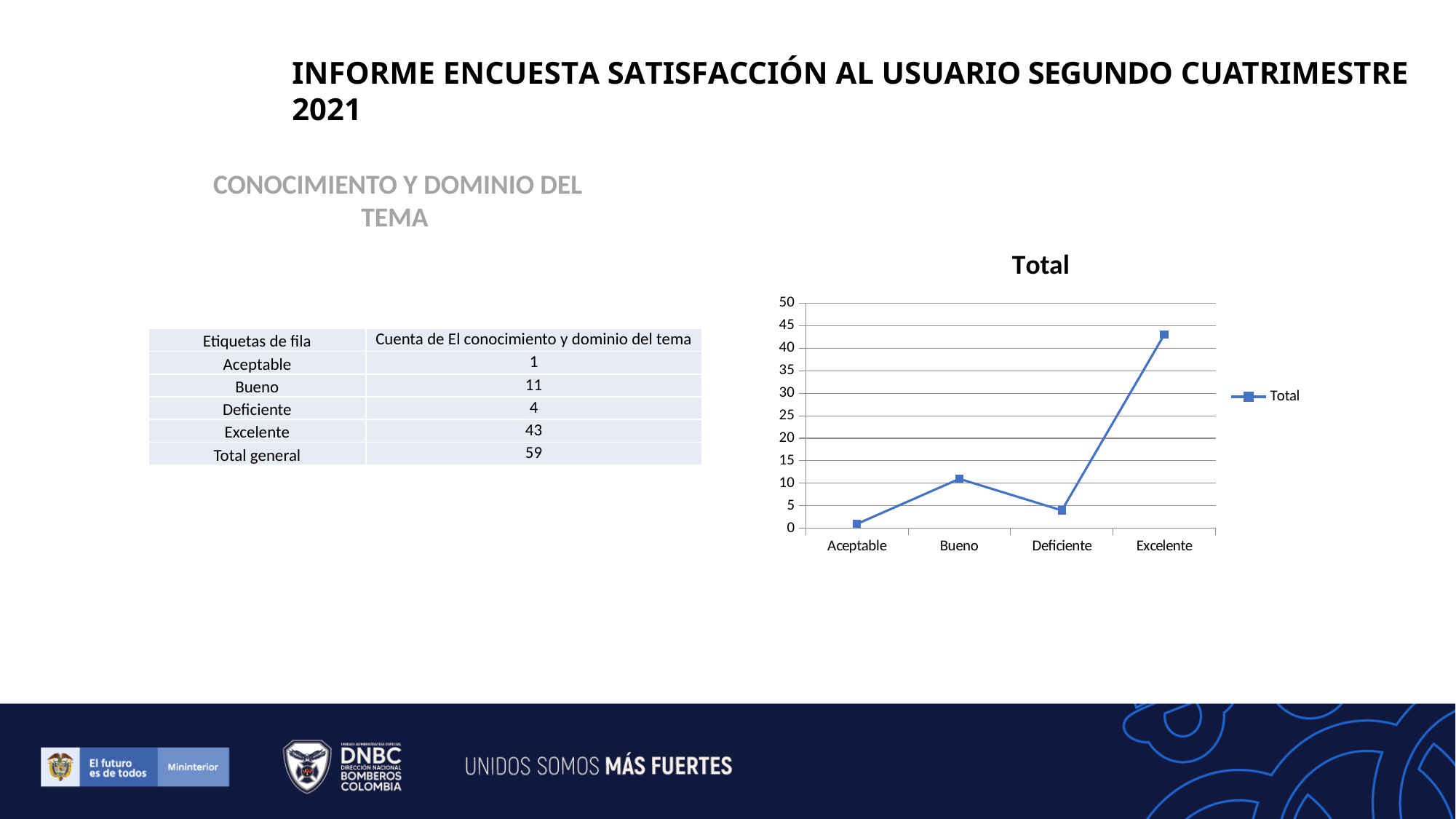
How many series does the chart legend list? 1 How many categories are plotted along the x axis of the chart? 4 Is the value for Bueno greater or less than 15? less What kind of chart is shown on the slide? line chart Which category has the lowest value in the chart? Aceptable Is the value for Excelente greater or less than 40? greater According to the table on the slide, what is the difference between the values for Excelente and Bueno? 32 Which is larger, the value for Bueno or the value for Deficiente? Bueno Is the value for Deficiente greater or less than 5? less What is the title of the chart? Total Which category has the highest value in the chart? Excelente According to the table on the slide, what is the value for Excelente? 43